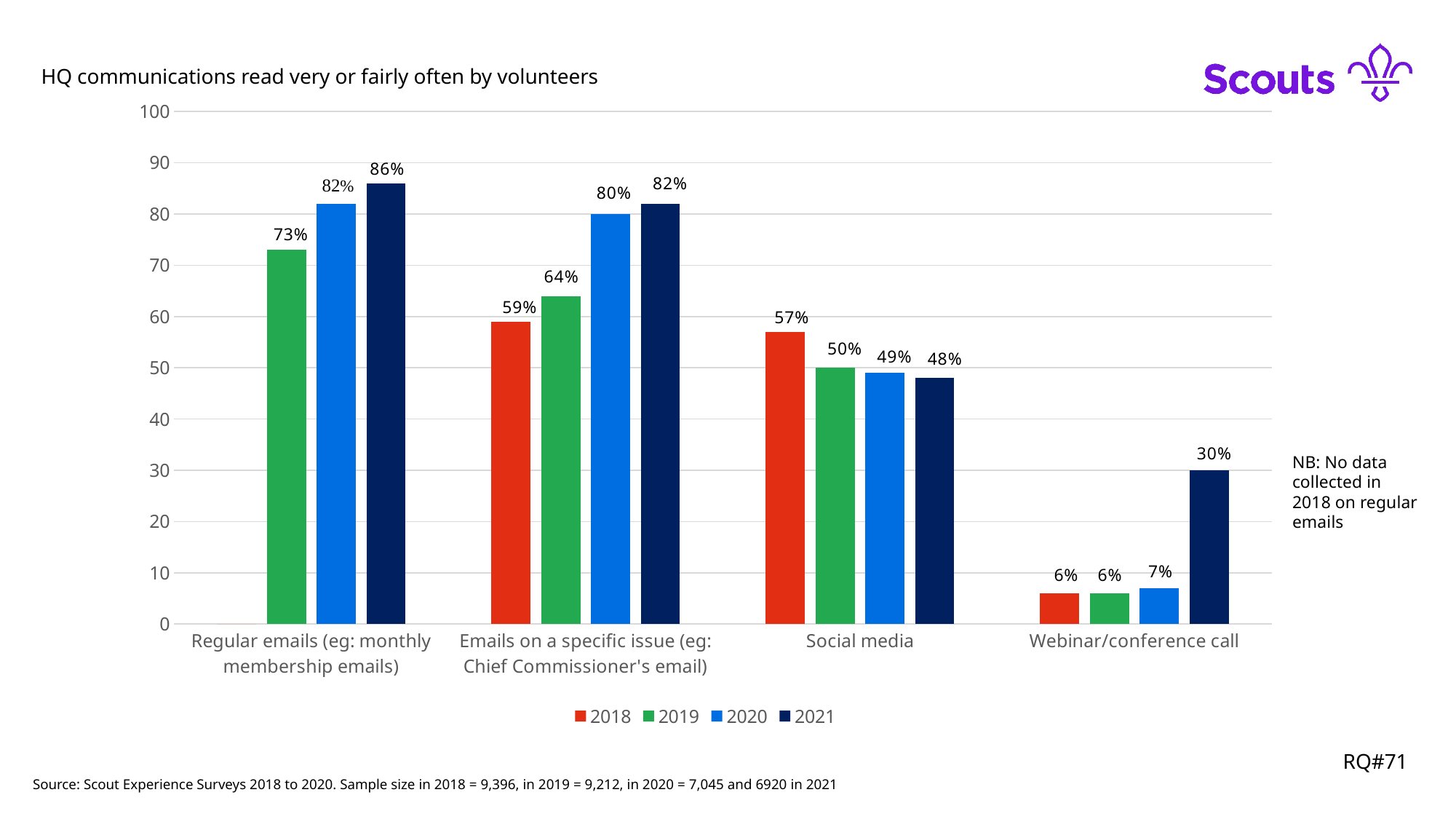
What kind of chart is shown? Bar chart Which category has the lowest value in 2020? Webinar/conference call Do the values for Social media rise or fall from 2018 to 2021? Fall What is the value for Social media in 2018? 57% What is the value for Emails on a specific issue in 2019? 64% What is the difference between the 2021 and 2018 values for Social media? 9% What percentage of volunteers read regular emails very or fairly often in 2021? 86% What is the value for Webinar/conference call in 2021? 30% Which category has the highest value in 2021? Regular emails (eg: monthly membership emails) Which is larger: the 2020 value for Regular emails or the 2020 value for Emails on a specific issue? Regular emails (eg: monthly membership emails) Which category has no 2018 bar? Regular emails (eg: monthly membership emails) How many series does the legend list? 4